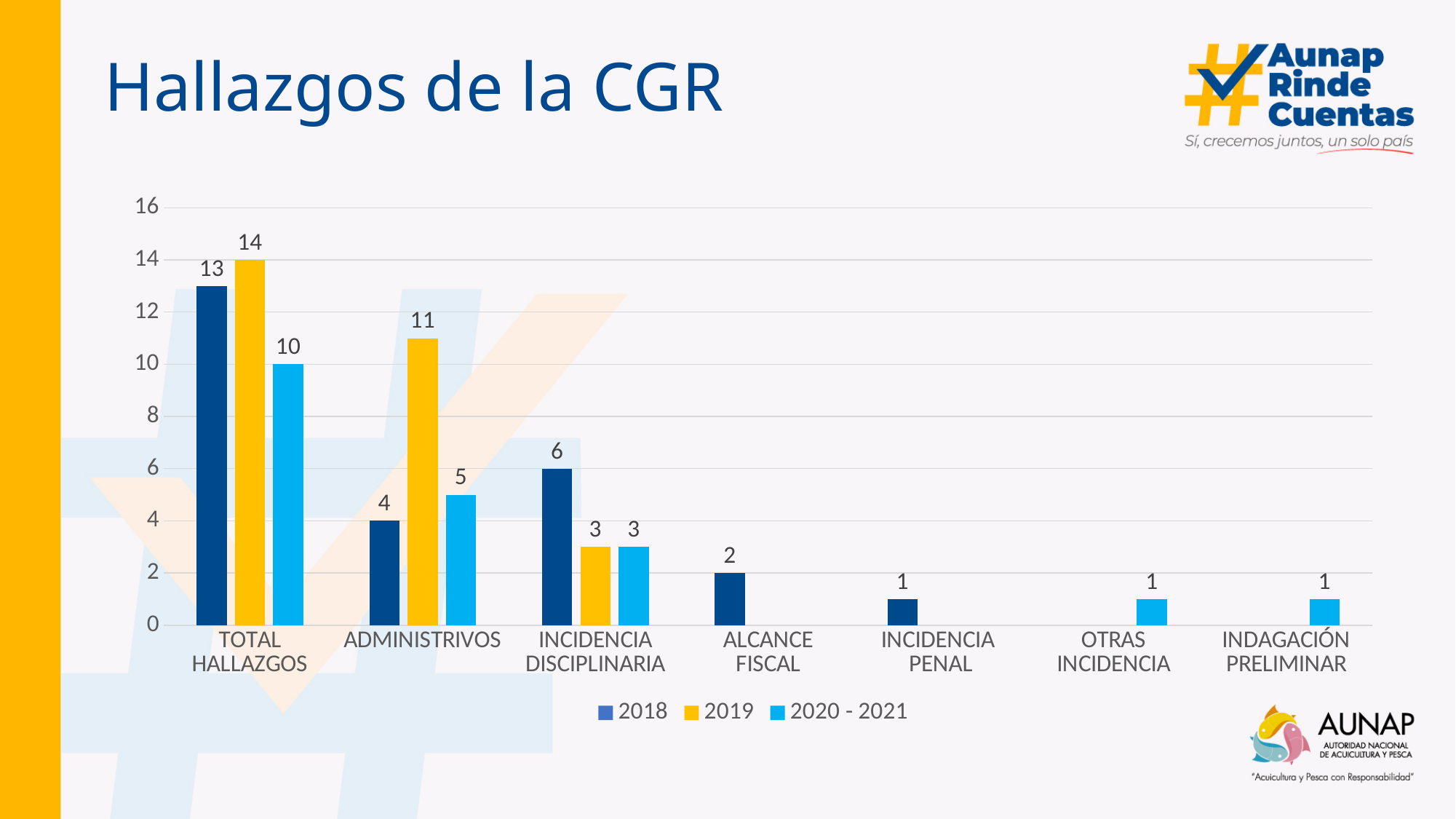
What is the value for 2019 in the TOTAL HALLAZGOS category? 14 Which year series has the lowest value in the TOTAL HALLAZGOS category? 2020 - 2021 Which year series has the highest value in the ADMINISTRATIVOS category? 2019 How many series does the legend list? 3 What is the difference between the 2019 and 2018 values in the ADMINISTRATIVOS category? 7 How many categories are shown on the x axis of the chart? 7 Which is larger: the 2018 value for INCIDENCIA DISCIPLINARIA or the 2018 value for ADMINISTRATIVOS? INCIDENCIA DISCIPLINARIA What is the title of the slide containing the chart? Hallazgos de la CGR What is the value for 2020 - 2021 in the ADMINISTRATIVOS category? 5 What is the value for 2018 in the ALCANCE FISCAL category? 2 What kind of chart is shown on the slide? Bar chart What is the value for 2018 in the INCIDENCIA DISCIPLINARIA category? 6